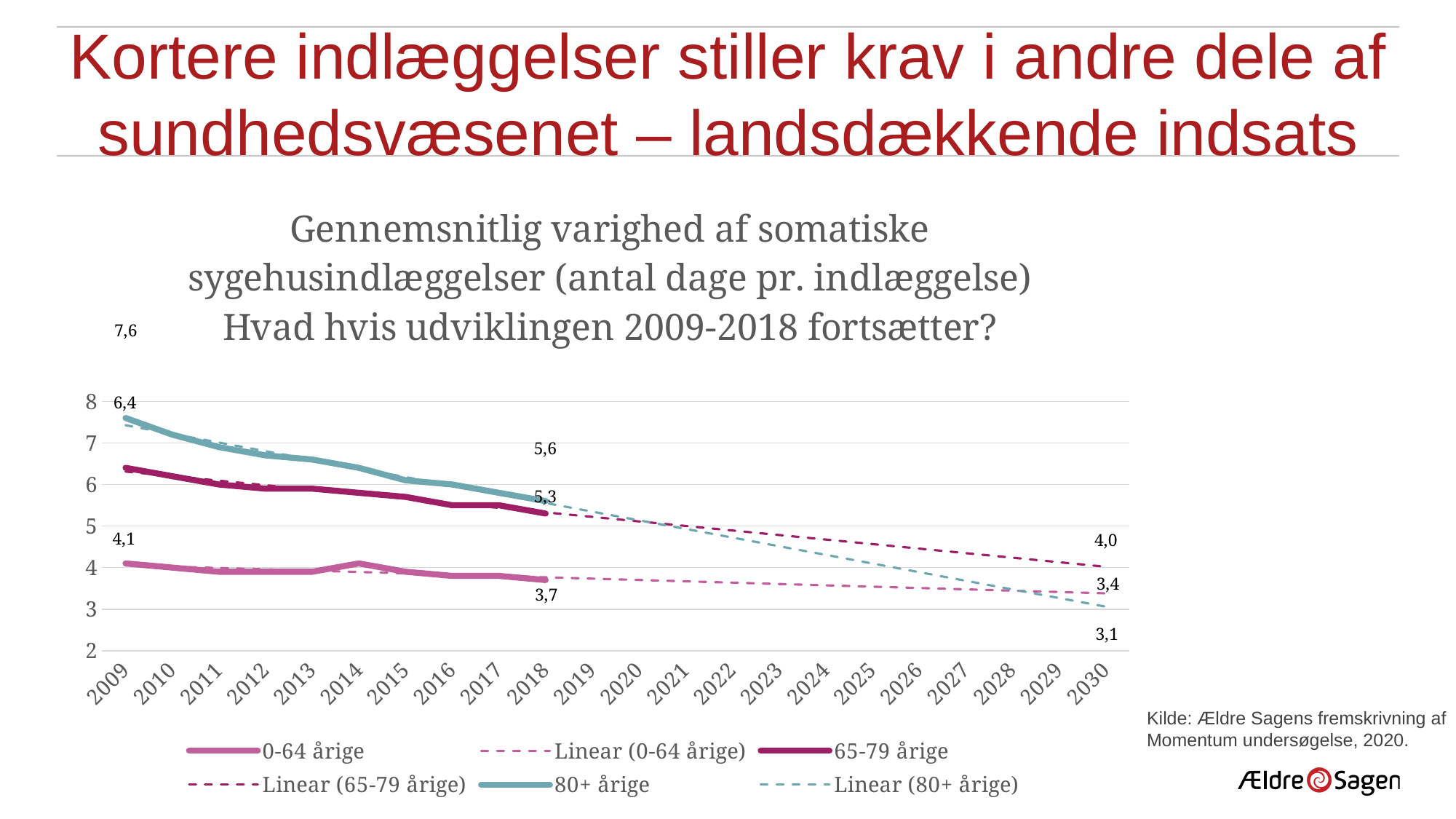
By how much did the value for the 80+ årige series fall from 2009 to 2018? 2,0 What type of chart is shown on the slide? line chart Which series has the lowest projected value in 2030? 80+ årige What is the projected value for the 80+ årige trendline in 2030? 3,1 How many entries does the legend list? 6 Does the value for the 80+ årige series rise or fall from 2009 to 2018? fall What is the value for the 0-64 årige series in 2018? 3,7 What is the value for the 80+ årige series in 2009? 7,6 What is the value for the 80+ årige series in 2018? 5,6 What is the value for the 65-79 årige series in 2009? 6,4 What is the projected value for the 65-79 årige trendline in 2030? 4,0 Which series has the highest value in 2009? 80+ årige